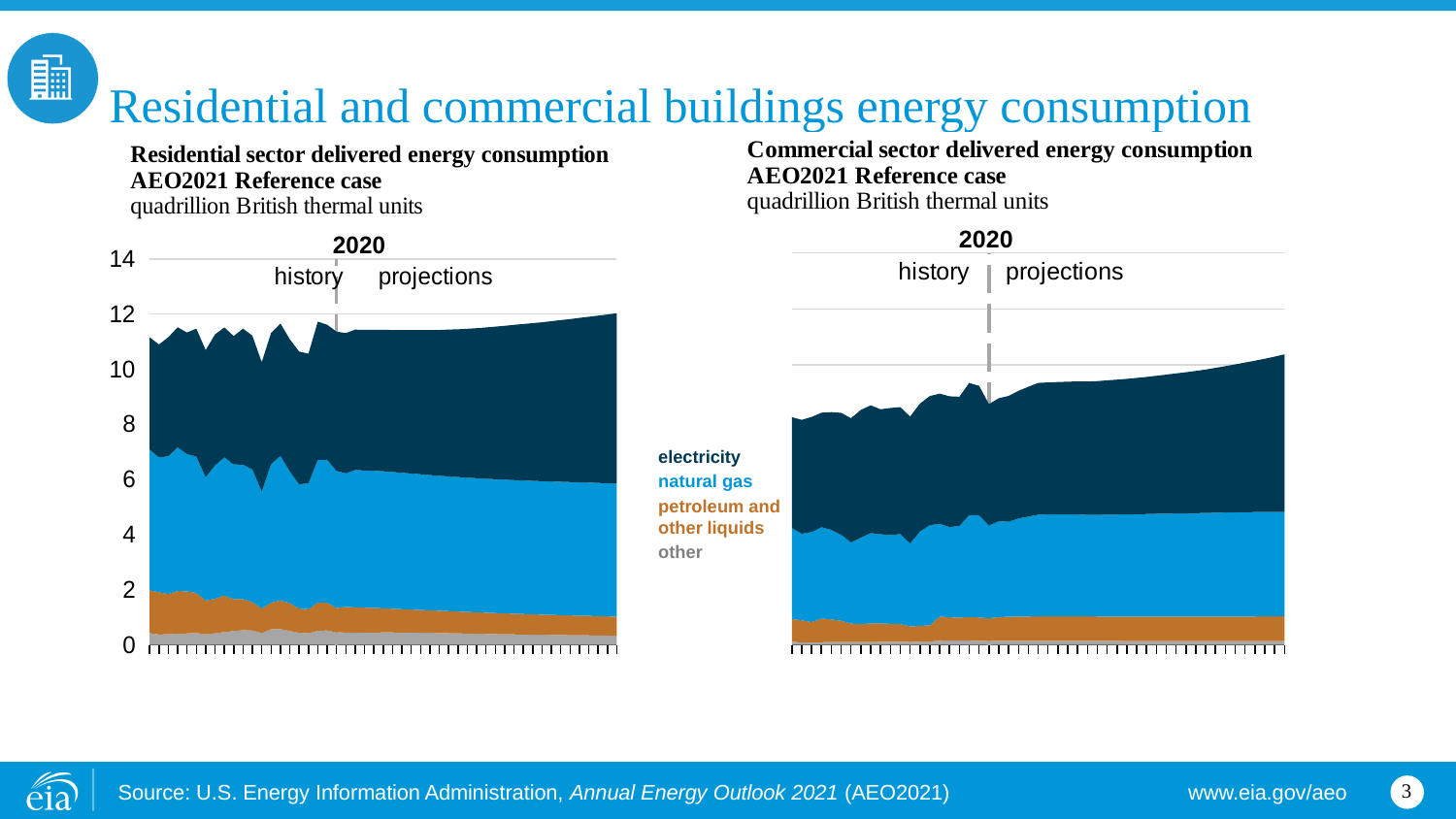
Which series is shown in the darkest (navy) colour on the charts? electricity In the commercial sector chart, does total delivered energy consumption rise or fall over the projection period? rise In the residential sector chart, is the total delivered energy consumption in 2020 greater or less than 14? less How many series does the shared legend between the two charts list? 4 Which chart shows the higher total delivered energy consumption in 2020, the residential sector chart or the commercial sector chart? residential sector chart In the residential sector chart, is the top of the petroleum and other liquids layer at the end of the projections greater or less than 4? less In the residential sector chart, does total delivered energy consumption rise or fall over the projection period? rise What kind of chart is the residential sector delivered energy consumption chart? stacked area chart In the residential sector chart, is the 'other' layer at the start of the history period greater or less than 2? less What year does the dashed vertical line separating history from projections mark on both charts? 2020 What unit of measurement is used on both charts? quadrillion British thermal units